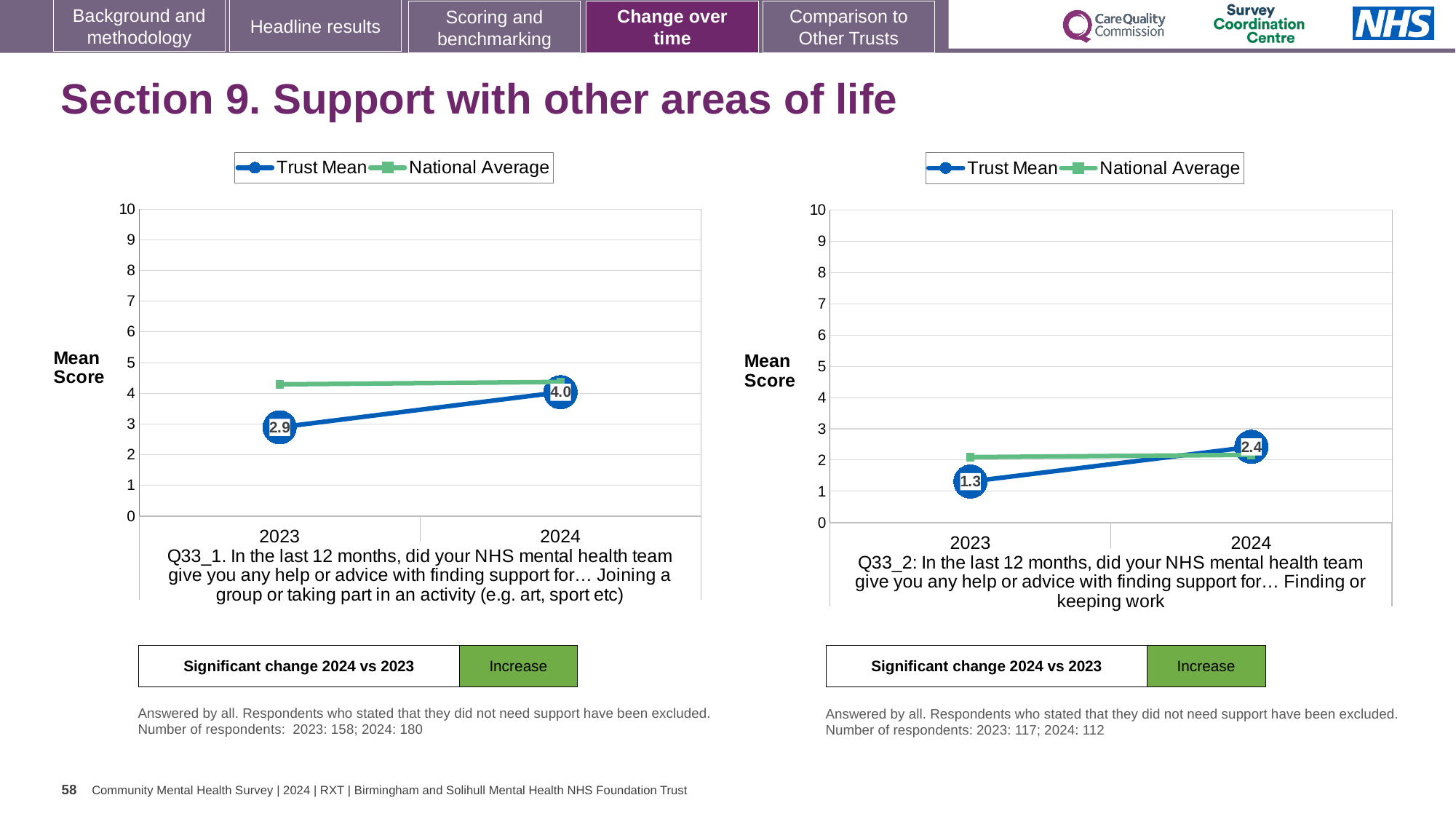
What type of chart is the left chart (Q33_1)? line chart In the left chart (Q33_1), what is the Trust Mean for 2023? 2.9 In the right chart (Q33_2), what is the Trust Mean for 2024? 2.4 How many series does the legend of the right chart (Q33_2) list? 2 In the right chart (Q33_2), by how much did the Trust Mean change from 2023 to 2024? 1.1 In the right chart (Q33_2), what is the Trust Mean for 2023? 1.3 In the left chart (Q33_1), what is the Trust Mean for 2024? 4.0 In the left chart (Q33_1), does the Trust Mean rise or fall from 2023 to 2024? rise In the left chart (Q33_1), which is higher in 2023, the Trust Mean or the National Average? National Average In the left chart (Q33_1), is the National Average for 2023 greater or less than 4? greater In the left chart (Q33_1), by how much did the Trust Mean change from 2023 to 2024? 1.1